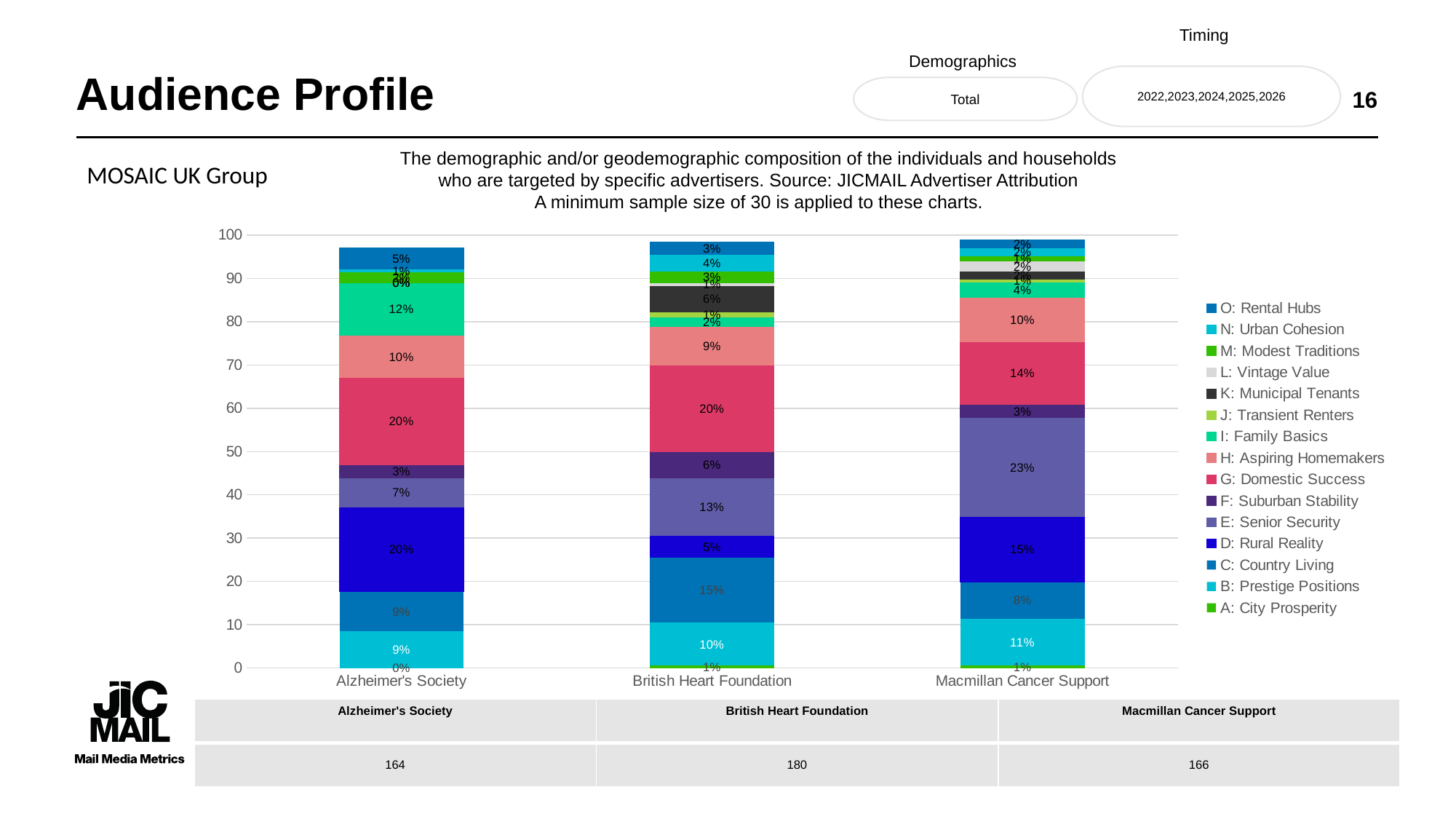
Which advertiser has the larger value for D: Rural Reality, Alzheimer's Society or British Heart Foundation? Alzheimer's Society What is the value for G: Domestic Success in the Alzheimer's Society bar? 20% What kind of chart is shown on the slide? Stacked bar chart What is the value for B: Prestige Positions in the Macmillan Cancer Support bar? 11% What is the difference in percentage points between the E: Senior Security values for Macmillan Cancer Support and Alzheimer's Society? 16 percentage points What is the value for C: Country Living in the British Heart Foundation bar? 15% What is the value for I: Family Basics in the Alzheimer's Society bar? 12% How many MOSAIC groups does the chart legend list? 15 How many advertisers (categories) are shown on the x axis of the chart? 3 Which advertiser has the lowest value for D: Rural Reality? British Heart Foundation What is the value for E: Senior Security in the Macmillan Cancer Support bar? 23% Which MOSAIC group is labelled 'H' in the chart legend? Aspiring Homemakers